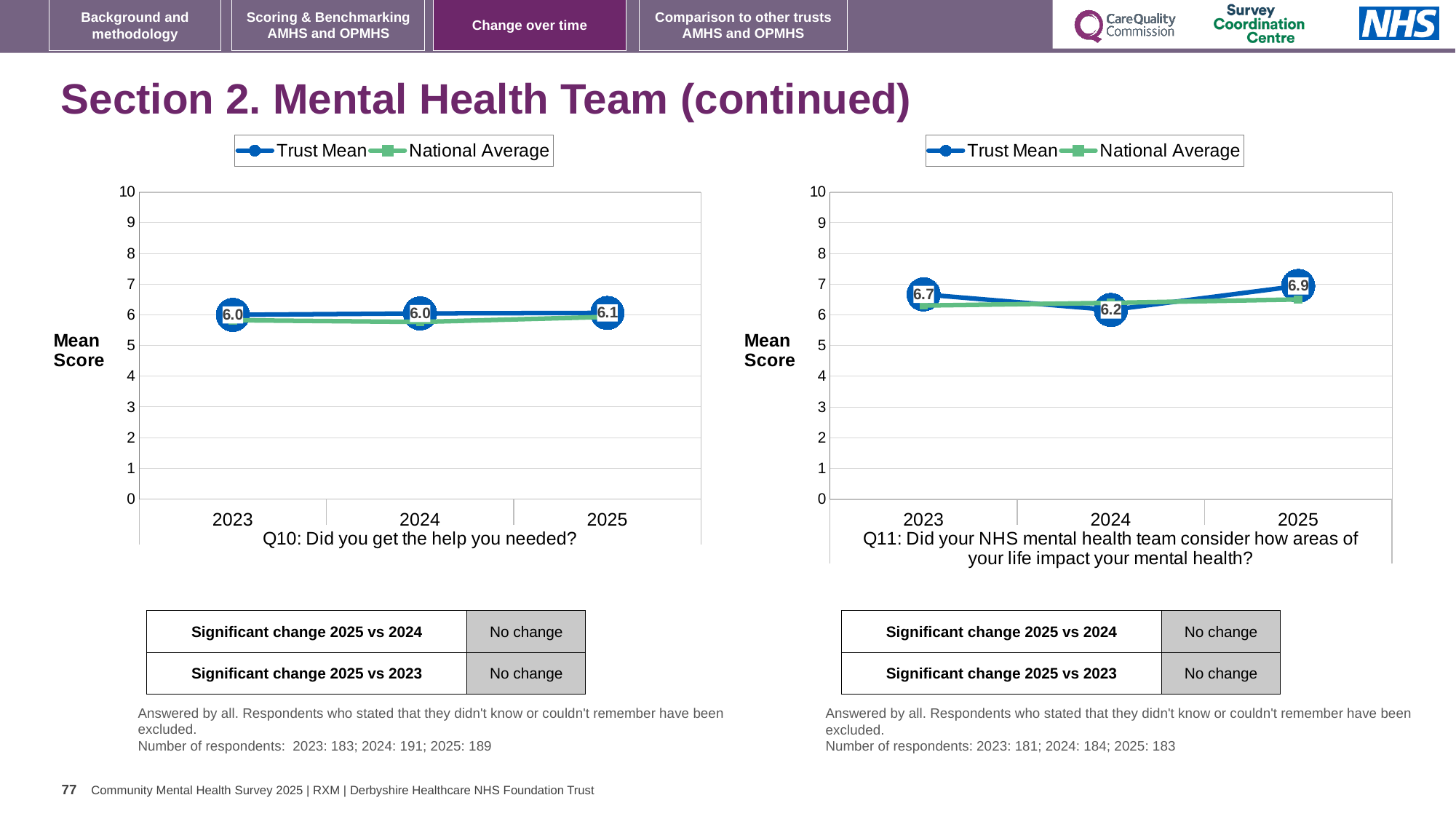
In the Q11 chart, which year has the highest Trust Mean? 2025 In the Q11 chart, what is the Trust Mean for 2024? 6.2 In the Q10 chart, is the Trust Mean for 2025 greater or less than 5? greater How many years are plotted on the x axis of the Q10 chart? 3 In the Q11 chart, what is the difference between the Trust Mean for 2025 and 2024? 0.7 What type of chart is the Q10 chart? Line chart In the Q11 chart, what is the Trust Mean for 2025? 6.9 In the Q11 chart, which year has the lowest Trust Mean? 2024 In the Q10 chart, what is the Trust Mean for 2025? 6.1 In the Q11 chart, which series is shown in green? National Average How many series does the legend of the Q11 chart list? 2 In the Q10 chart, what is the Trust Mean for 2023? 6.0